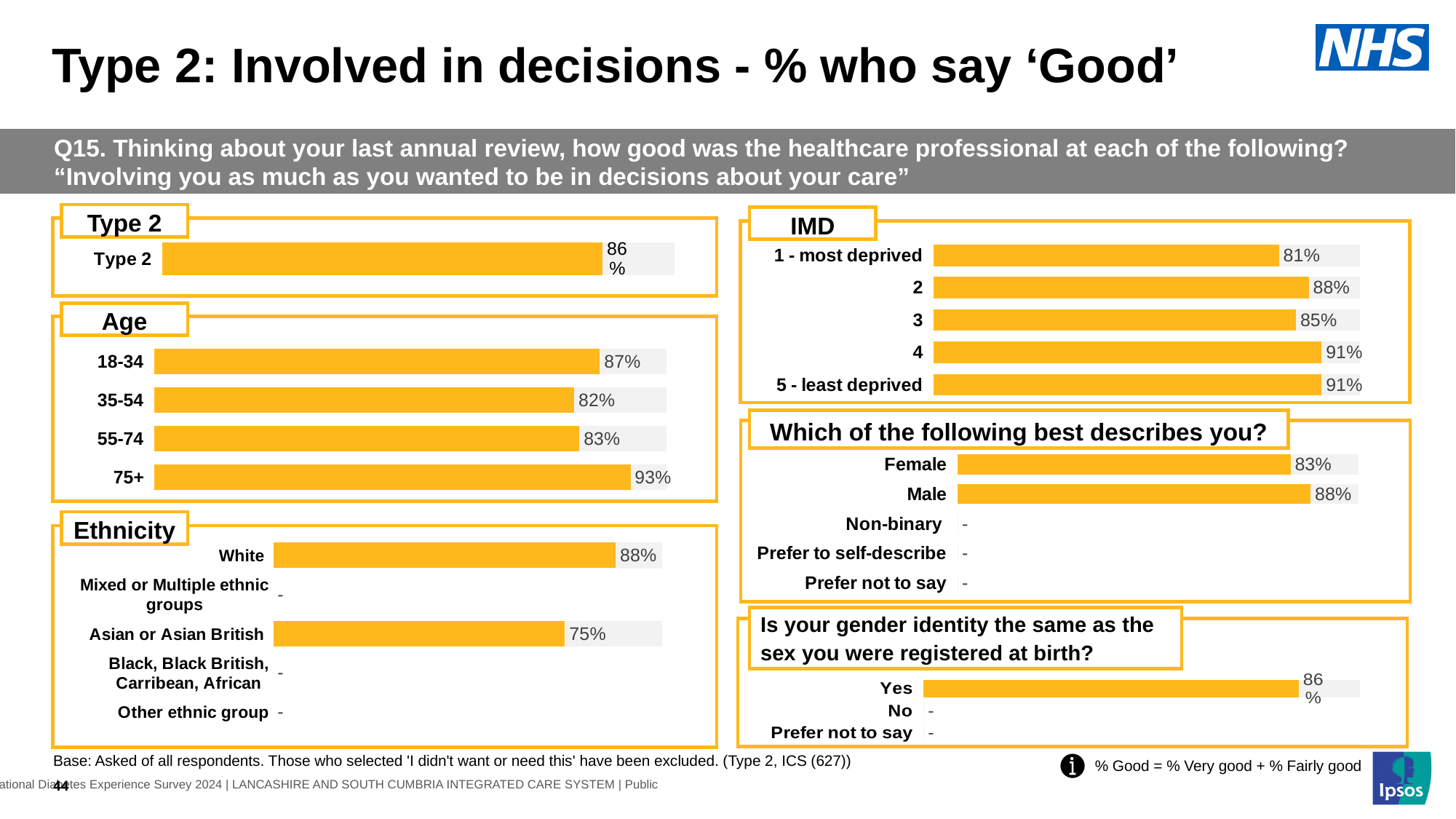
In the 'Is your gender identity the same as the sex you were registered at birth?' chart, what is the value for Yes? 86% In the IMD chart, which category has the lowest value? 1 - most deprived In the Age chart, which age group has the highest value? 75+ In the Age chart, which age group has the lowest value? 35-54 In the Age chart, what is the difference between the values for 75+ and 35-54? 11 percentage points In the Ethnicity chart, which is larger, the value for White or the value for Asian or Asian British? White In the IMD chart, what is the value for 1 - most deprived? 81% In the Ethnicity chart, what is the value for Asian or Asian British? 75% In the Type 2 chart, what is the value for Type 2? 86% In the IMD chart, how many categories are shown? 5 What kind of chart is the Age chart? Bar chart In the 'Which of the following best describes you?' chart, what is the difference between the values for Male and Female? 5 percentage points